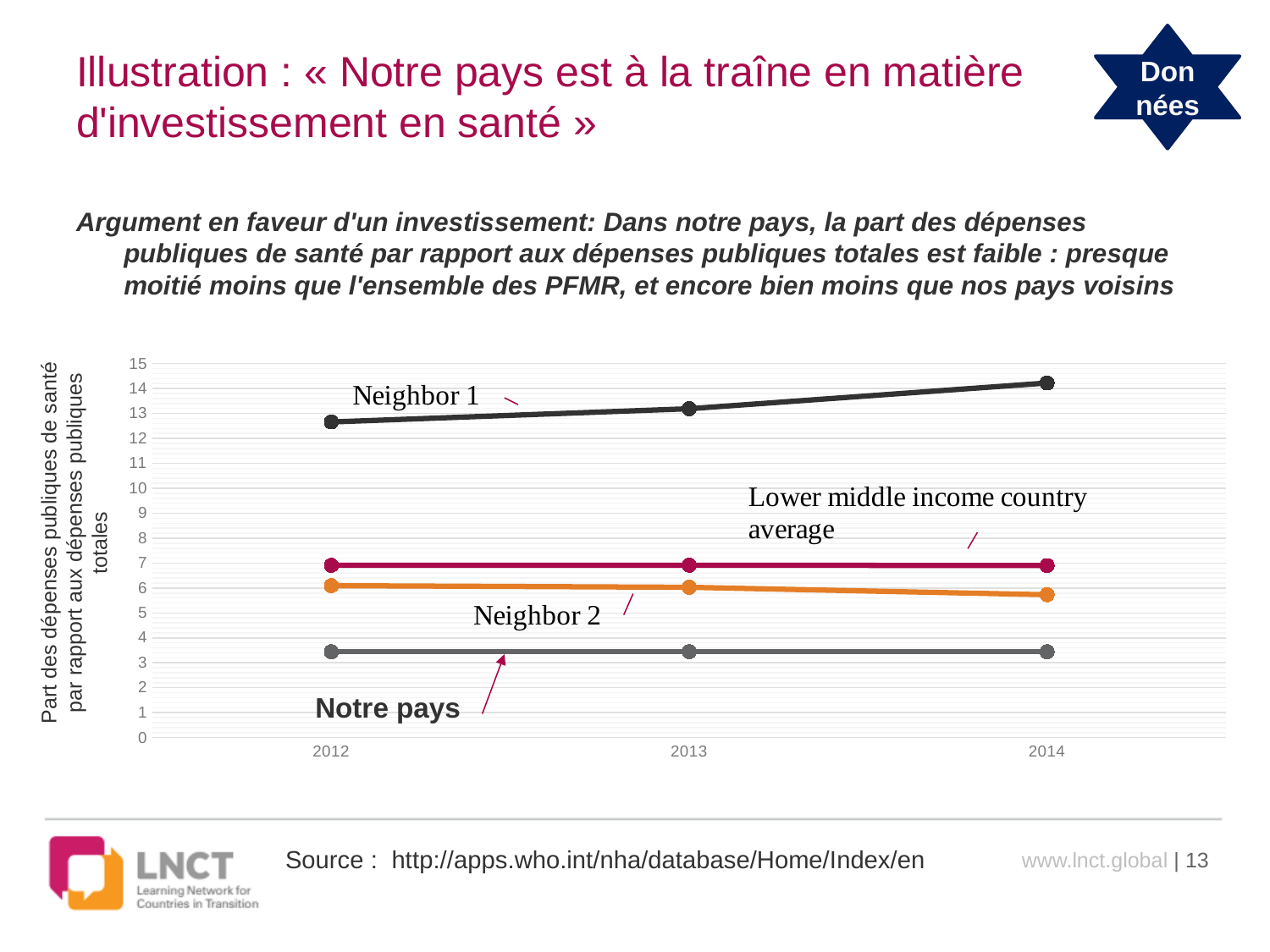
Does the line for Neighbor 2 rise or fall from 2012 to 2014? fall Is the value for Notre pays in 2013 greater or less than 4? less How many years are shown on the x axis of the chart? 3 Does the line for Neighbor 1 rise or fall from 2012 to 2014? rise In 2014, which is larger: the Lower middle income country average or Neighbor 2? Lower middle income country average Is the value for Neighbor 2 in 2014 greater or less than 6? less Is the value for Neighbor 1 in 2012 greater or less than 12? greater Which series has the lowest values on the chart? Notre pays What is the title of the y axis of the chart? Part des dépenses publiques de santé par rapport aux dépenses publiques totales How many lines (series) are plotted on the chart? 4 Which series has the highest values on the chart? Neighbor 1 What kind of chart is shown on the slide? line chart